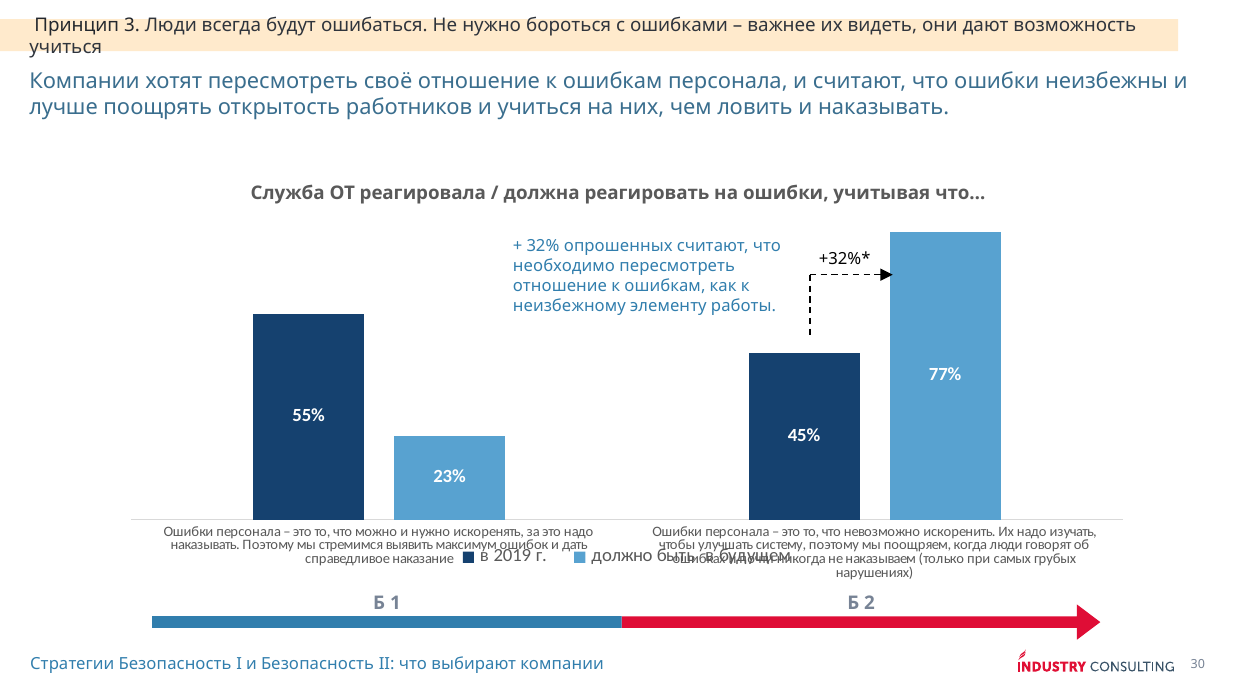
What is the value for the series "в 2019 г." in the left category (Б 1)? 55% Which bar in the chart has the lowest value? должно быть (в будущем) in Б 1 (23%) What is the title of the chart? Служба ОТ реагировала / должна реагировать на ошибки, учитывая что… What is the difference between the "должно быть (в будущем)" value and the "в 2019 г." value in the right category (Б 2)? 32% In the left category (Б 1), which series has the larger value: "в 2019 г." or "должно быть (в будущем)"? в 2019 г. What is the value for the series "должно быть (в будущем)" in the right category (Б 2)? 77% What is the value for the series "в 2019 г." in the right category (Б 2)? 45% What type of chart is shown on the slide? Bar chart What is the value for the series "должно быть (в будущем)" in the left category (Б 1)? 23% What is the difference between the "в 2019 г." value and the "должно быть (в будущем)" value in the left category (Б 1)? 32% Which bar in the chart has the highest value? должно быть (в будущем) in Б 2 (77%) How many series does the chart legend list? 2